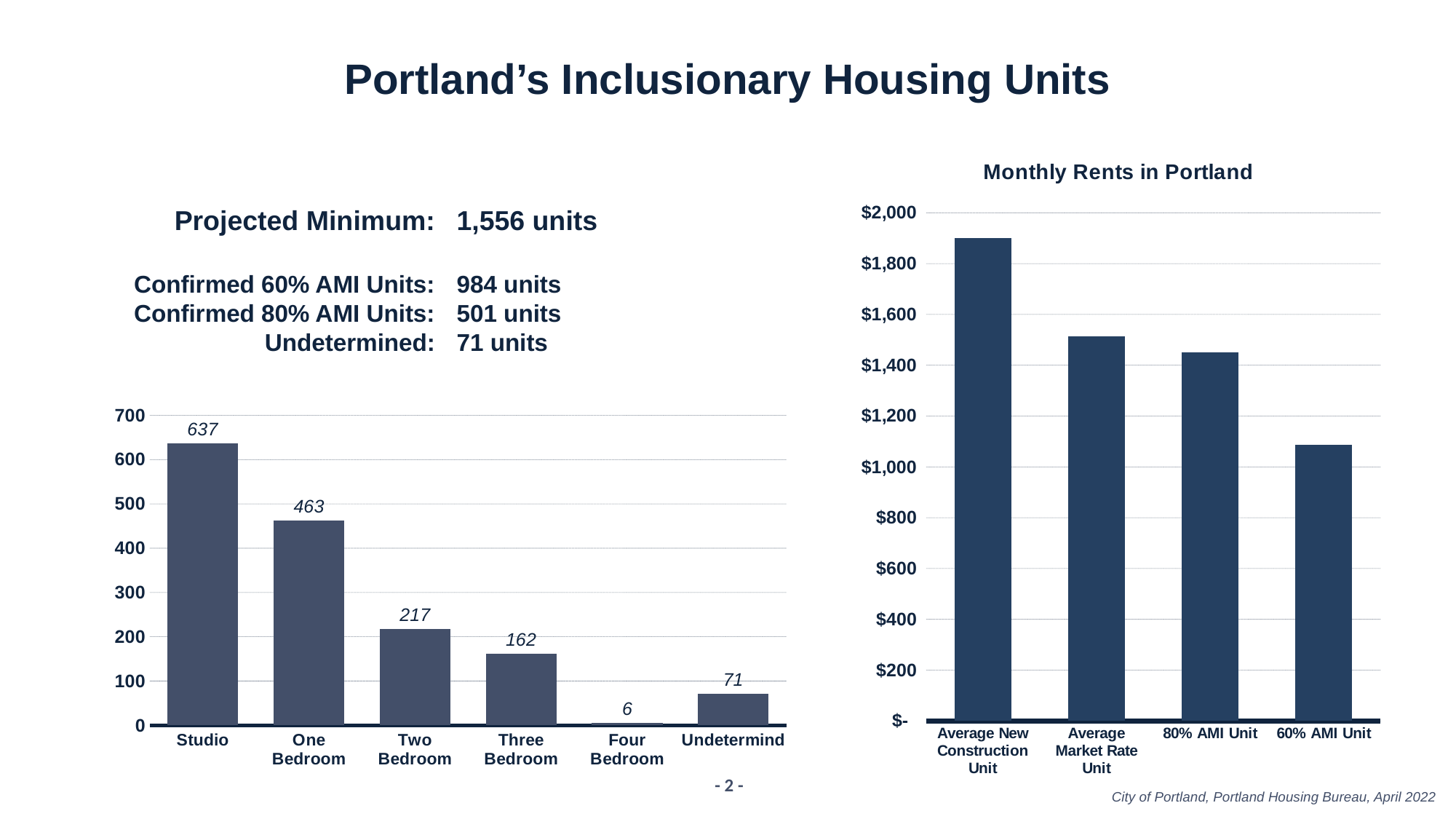
On the left chart, which category has the lowest value? Four Bedroom On the Monthly Rents in Portland chart, is the value for 60% AMI Unit greater or less than $1,200? less On the left chart, what is the difference between the Studio and One Bedroom values? 174 On the Monthly Rents in Portland chart, which category has the highest rent? Average New Construction Unit On the left chart, which category has the highest value? Studio What kind of chart is the Monthly Rents in Portland chart? Bar chart On the left chart, how many units are shown for Studio? 637 On the left chart, is the value for Three Bedroom larger than the value for Undetermind? Yes On the left chart, how many categories are shown on the x axis? 6 On the Monthly Rents in Portland chart, which category has the lowest rent? 60% AMI Unit On the left chart, what is the value for Two Bedroom? 217 On the Monthly Rents in Portland chart, is the value for Average New Construction Unit greater or less than $1,800? greater